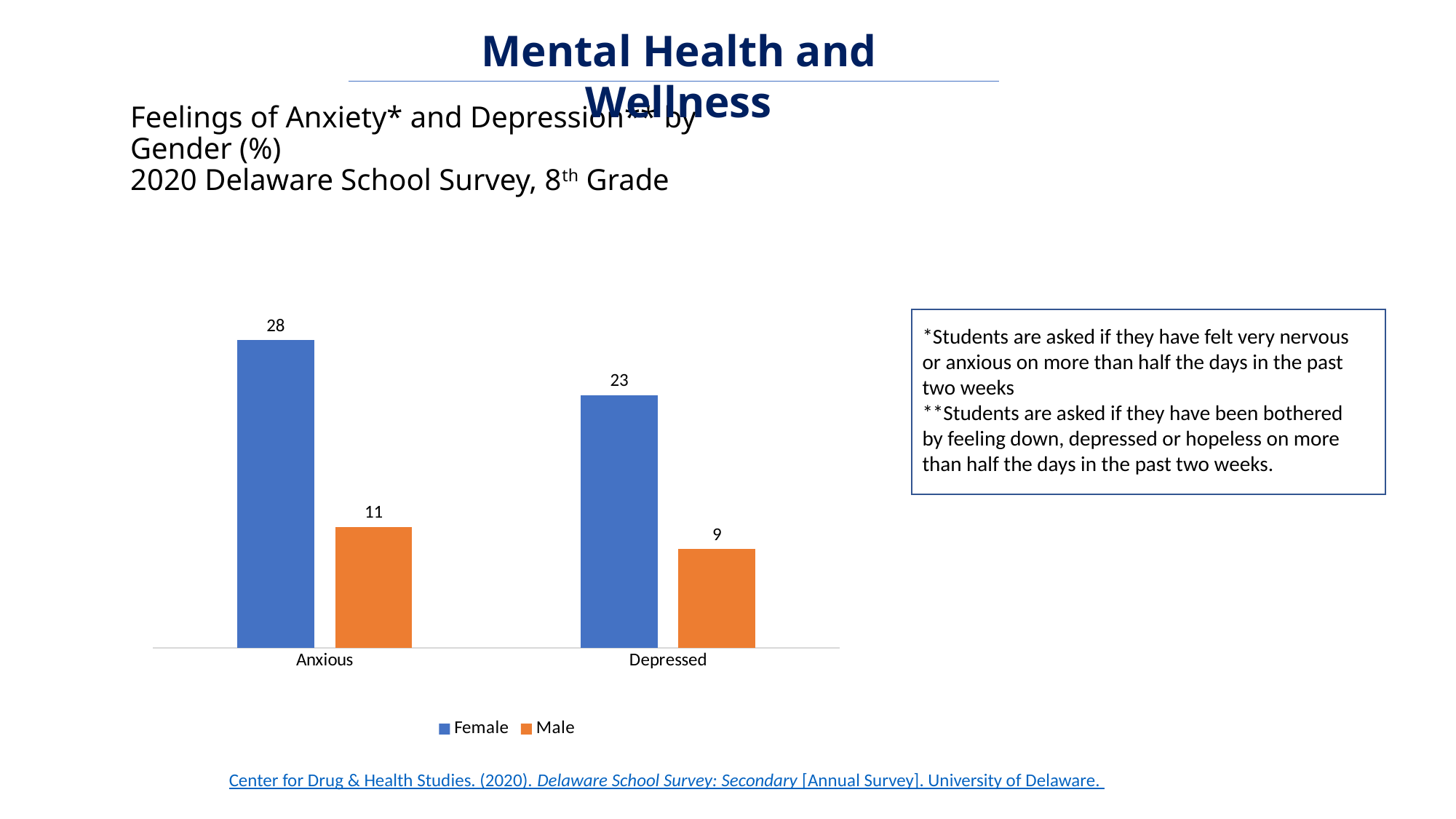
What is the value for Male in the Anxious category? 11 What percentage of male 8th graders reported feeling depressed? 9 What kind of chart is shown on the slide? Bar chart What is the difference between the Female and Male values for Anxious? 17 What percentage of female 8th graders reported feeling anxious? 28 Which is larger, the Male value for Anxious or the Male value for Depressed? Anxious How many categories are shown on the x axis? 2 Which bar has the lowest value on the chart? Male, Depressed Which bar has the highest value on the chart? Female, Anxious How many series does the legend list? 2 What is the value for Female in the Depressed category? 23 What is the difference between the Female values for Anxious and Depressed? 5